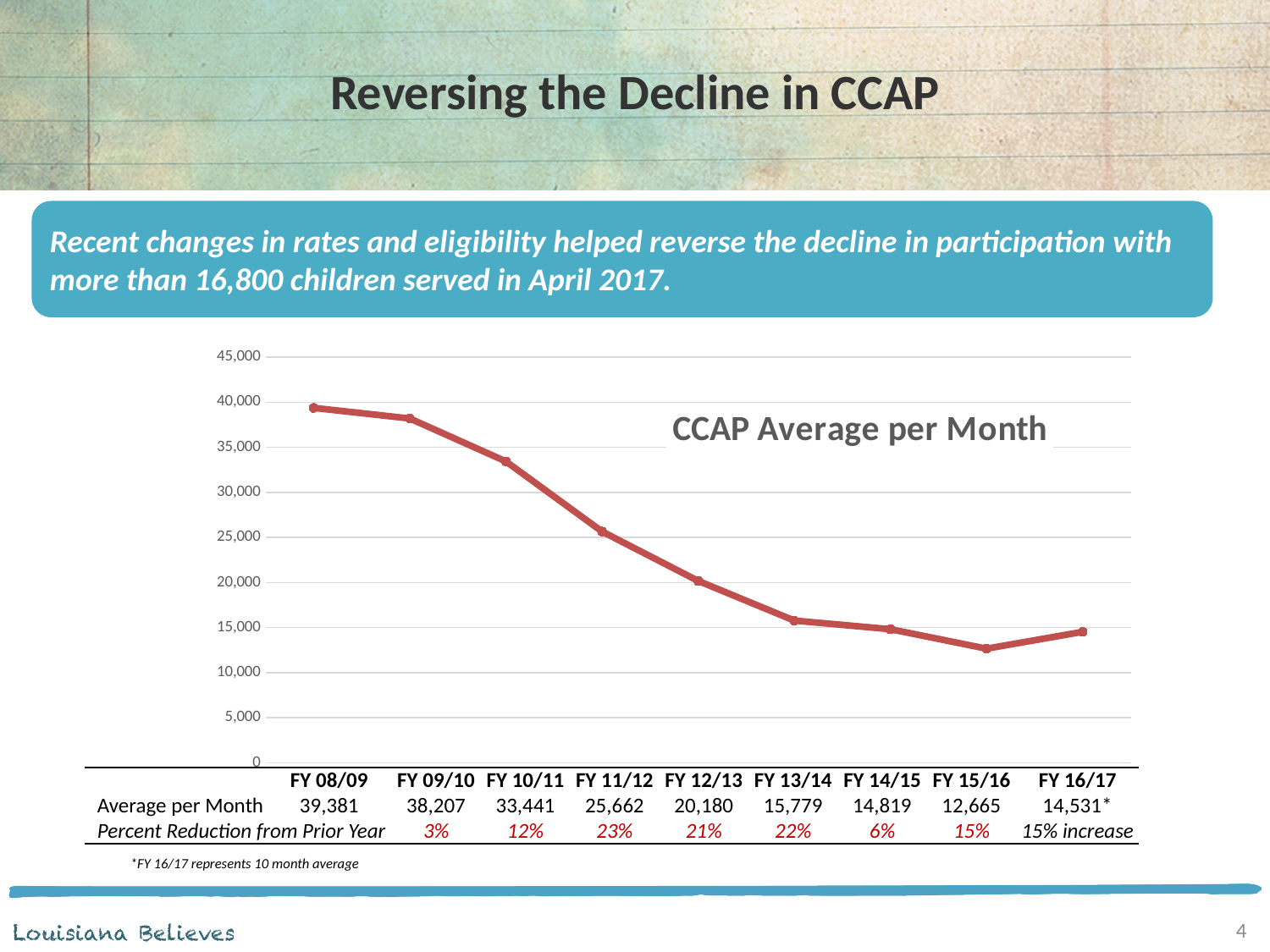
What is the difference between the CCAP average per month in FY 08/09 and FY 09/10? 1,174 Is the CCAP average per month for FY 11/12 greater or less than 25,000? greater By how much did the CCAP average per month increase from FY 15/16 to FY 16/17? 1,866 Which fiscal year has the lowest CCAP average per month? FY 15/16 How many fiscal years are plotted on the CCAP Average per Month chart? 9 What is the CCAP average per month for FY 08/09? 39,381 What is the CCAP average per month for FY 12/13? 20,180 What is the CCAP average per month for FY 15/16? 12,665 Which is larger, the CCAP average per month in FY 14/15 or in FY 16/17? FY 14/15 What kind of chart is used to show the CCAP Average per Month? line chart What is the percent reduction from the prior year shown for FY 11/12? 23% Which fiscal year has the highest CCAP average per month? FY 08/09